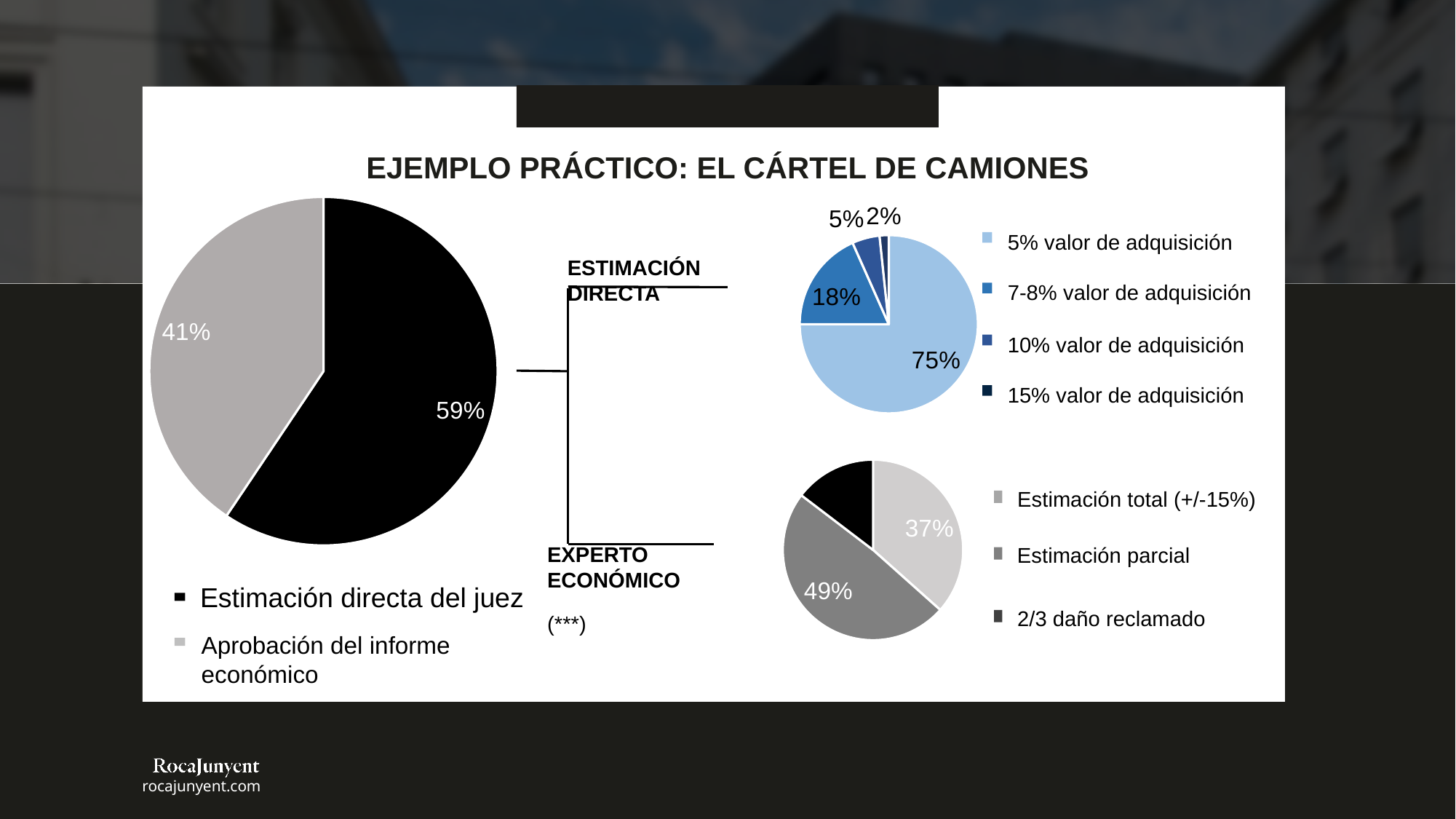
In the bottom-right pie chart, which is larger: 'Estimación parcial' or 'Estimación total (+/-15%)'? Estimación parcial In the large pie chart on the left, what is the difference in percentage points between the two slices? 18 In the bottom-right pie chart, what share is labelled for 'Estimación total (+/-15%)'? 37% How many categories does the legend of the top-right pie chart list? 4 In the top-right pie chart, which category has the smallest share? 15% valor de adquisición In the large pie chart on the left, which category has the larger share? Estimación directa del juez In the bottom-right pie chart, what share is labelled for 'Estimación parcial'? 49% In the top-right pie chart, what share is labelled for '7-8% valor de adquisición'? 18% In the large pie chart on the left, what share is labelled for 'Estimación directa del juez'? 59% What type of chart is the large chart on the left of the slide? Pie chart In the large pie chart on the left, what share is labelled for 'Aprobación del informe económico'? 41% In the top-right pie chart, what share is labelled for '5% valor de adquisición'? 75%